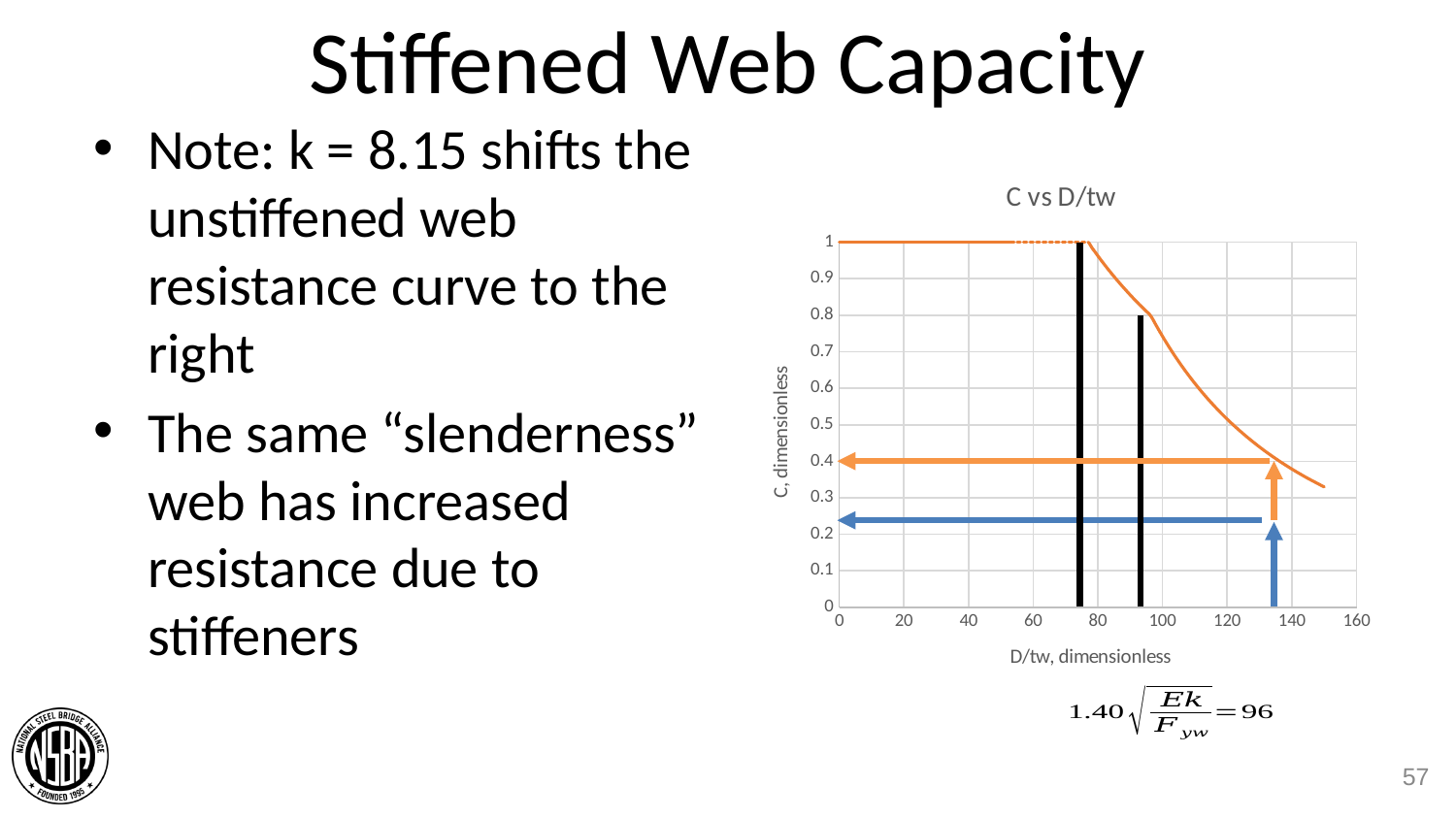
What is the title of the chart? C vs D/tw What is the label of the x axis of the chart? D/tw, dimensionless What kind of chart is shown on the slide? line chart Does the curve rise or fall as D/tw increases beyond 80? falls Is the value of C at D/tw = 140 greater or less than 0.5? less What is the highest value shown on the x axis of the chart? 160 Is the value of C at D/tw = 140 greater or less than 0.3? greater Is the value of C at D/tw = 120 greater or less than 0.7? less What is the value of C on the curve at D/tw = 40? 1 What is the value of C on the curve at D/tw = 0? 1